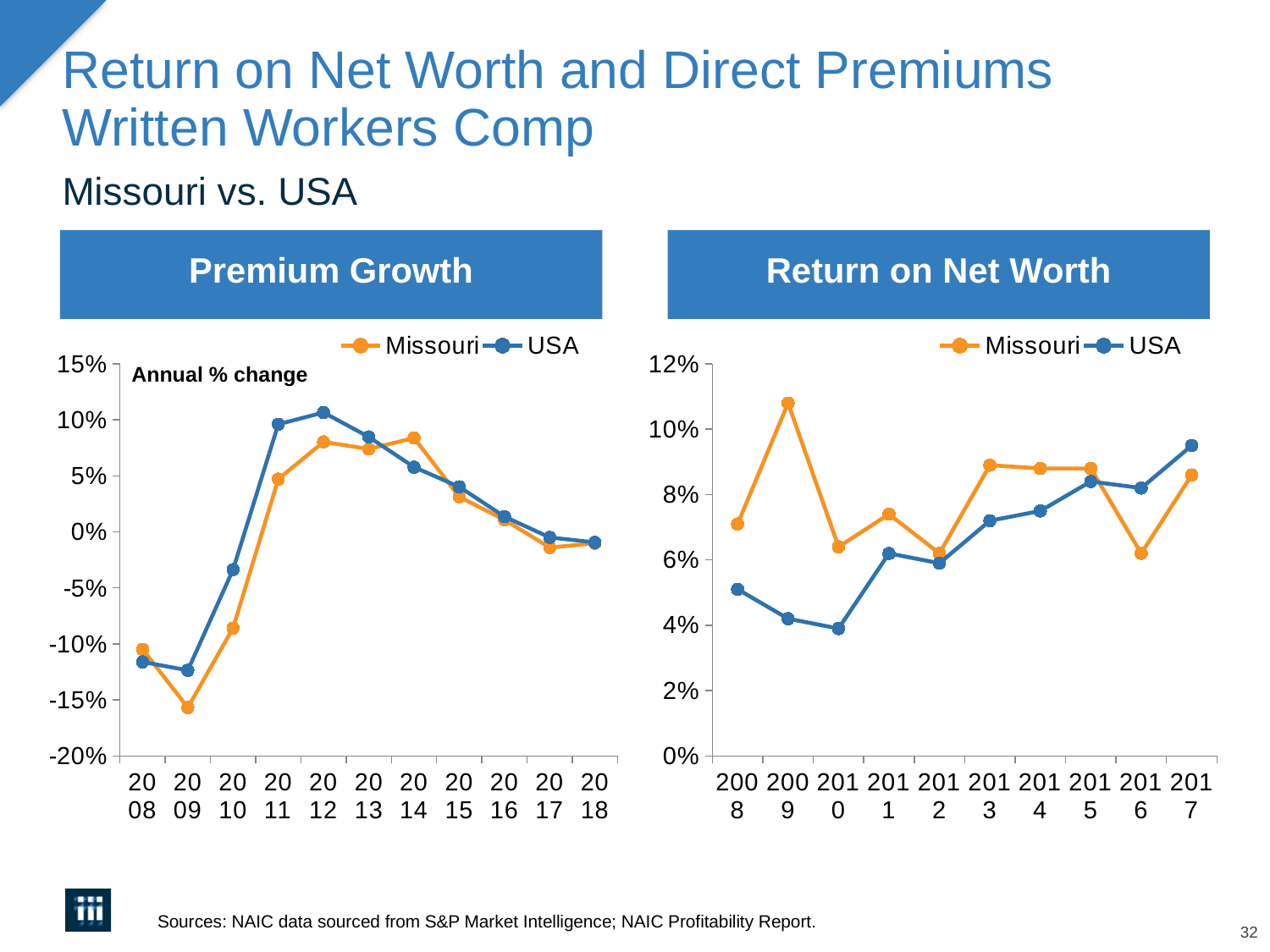
In the Return on Net Worth chart, in which year is the Missouri value highest? 2009 In the Premium Growth chart, is the USA value for 2010 greater or less than -5%? greater In the Return on Net Worth chart, in which year is the USA value highest? 2017 How many years are plotted on the x axis of the Premium Growth chart? 11 In the Premium Growth chart, in which year is the USA value highest? 2012 How many series does the legend of the Return on Net Worth chart list? 2 In the Return on Net Worth chart, which is larger in 2016, Missouri or USA? USA How many years are plotted on the x axis of the Return on Net Worth chart? 10 In the Return on Net Worth chart, is the Missouri value for 2009 greater or less than 10%? greater What kind of chart is the Premium Growth chart? line chart In the Premium Growth chart, in which year is the Missouri value lowest? 2009 In the Premium Growth chart, is the USA value for 2012 greater or less than 10%? greater